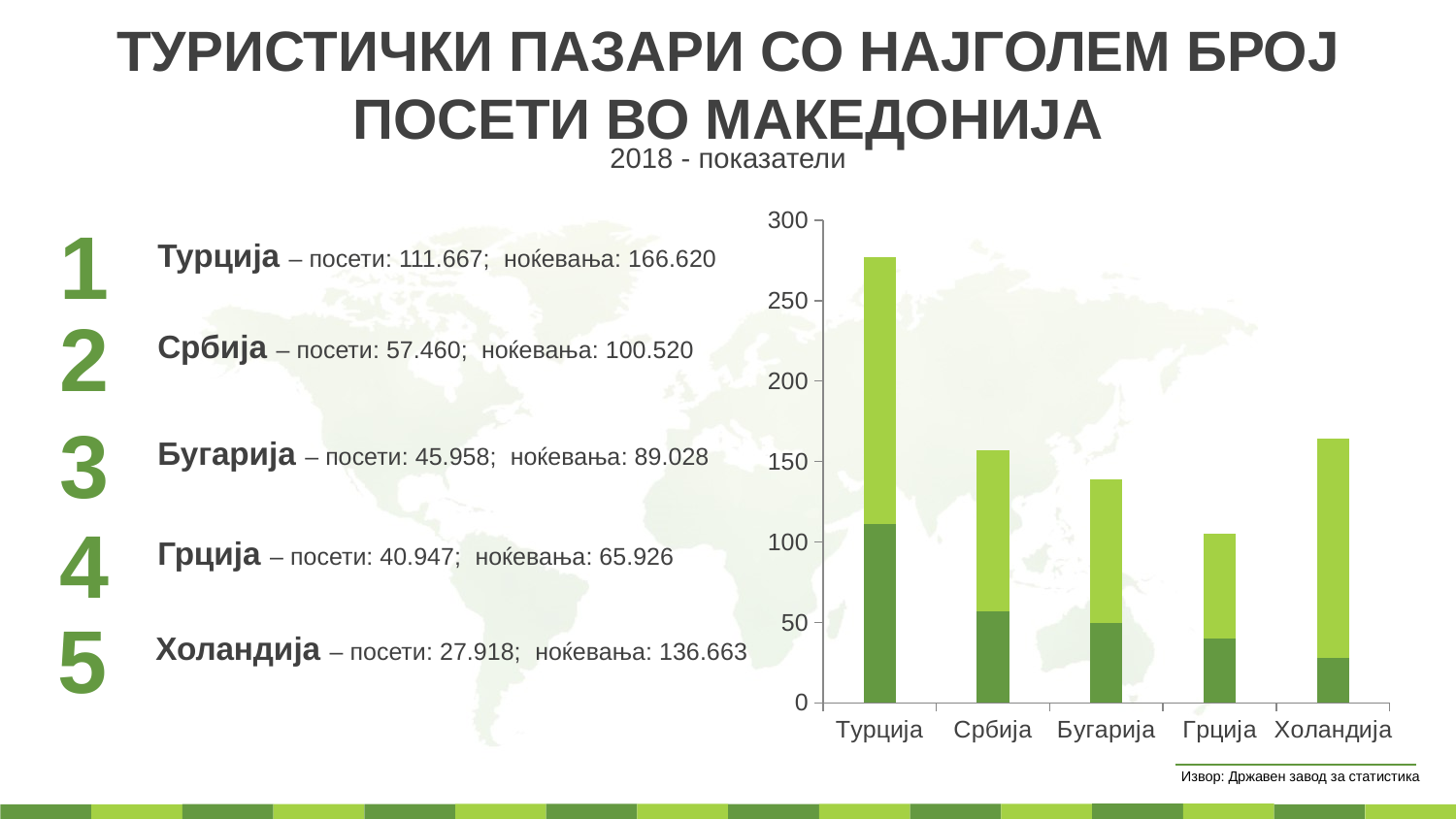
Which bar is taller, Холандија or Бугарија? Холандија Is the total bar height for Турција greater or less than 250? greater Which country has the tallest bar in the chart? Турција Is the total bar height for Холандија greater or less than 150? greater Do the total bar heights rise or fall from Турција to Грција along the x axis? fall What year do the indicators on the slide refer to, according to the subtitle? 2018 Is the total bar height for Бугарија greater or less than 150? less What kind of chart is shown on the slide? Stacked bar chart Which country has the largest dark green (bottom) segment? Турција Which country has the shortest bar in the chart? Грција How many countries are shown on the x axis of the chart? 5